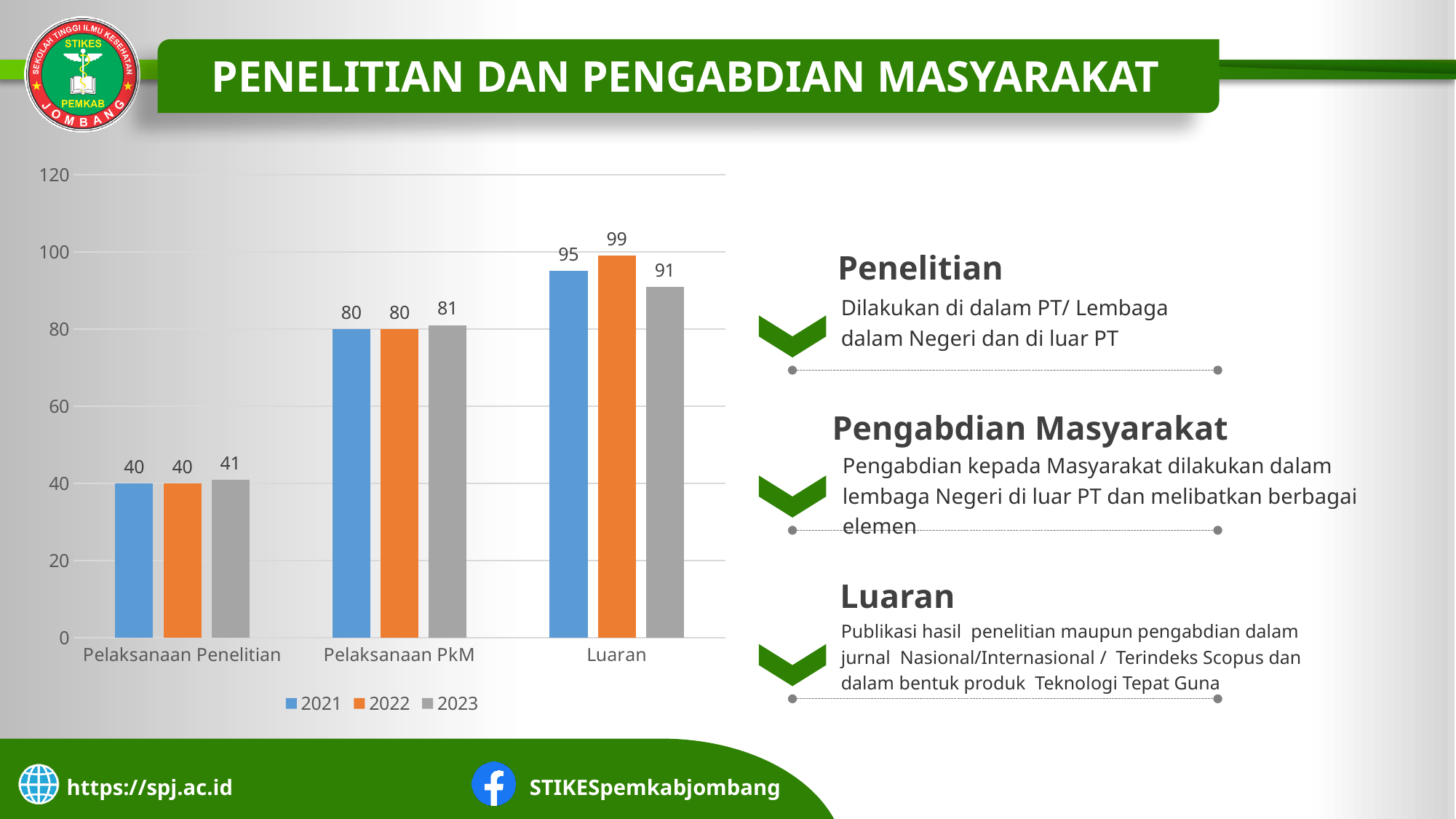
What is the difference between the 2022 and 2023 values for Luaran? 8 What is the value for Pelaksanaan PkM in 2021? 80 What is the value for Pelaksanaan Penelitian in 2023? 41 Which category has the highest value in 2022? Luaran Which colour represents the 2022 series in the legend? orange How many series does the legend list? 3 Which is larger for Luaran: the 2021 value or the 2023 value? 2021 Is the value for Luaran in 2021 greater or less than 80? greater How many categories are shown on the x axis? 3 What is the value for Luaran in 2022? 99 What kind of chart is shown on the slide? bar chart Which category has the lowest value in 2021? Pelaksanaan Penelitian